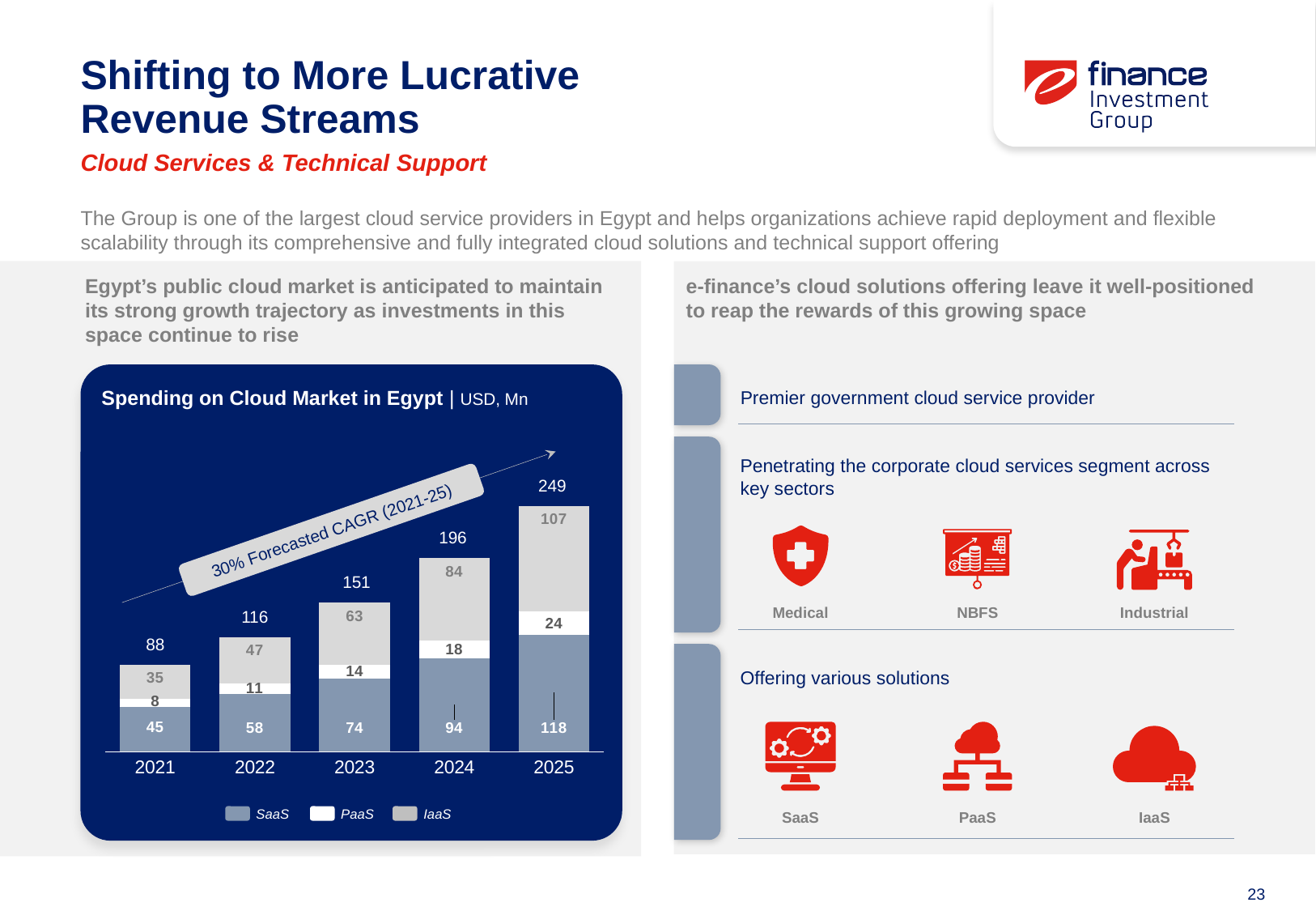
What is the total spending shown for 2024 in the Spending on Cloud Market in Egypt chart? 196 What is the IaaS value for 2025 in the Spending on Cloud Market in Egypt chart? 107 Which year has the lowest total spending in the Spending on Cloud Market in Egypt chart? 2021 What kind of chart is the Spending on Cloud Market in Egypt chart? Stacked bar chart In the Spending on Cloud Market in Egypt chart, which is larger in 2022: the SaaS value or the IaaS value? SaaS Do the total spending values in the Spending on Cloud Market in Egypt chart rise or fall from 2021 to 2025? Rise How many years are shown on the x axis of the Spending on Cloud Market in Egypt chart? 5 What is the SaaS value for 2023 in the Spending on Cloud Market in Egypt chart? 74 Which year has the highest total spending in the Spending on Cloud Market in Egypt chart? 2025 What is the PaaS value for 2021 in the Spending on Cloud Market in Egypt chart? 8 How many series does the legend of the Spending on Cloud Market in Egypt chart list? 3 What is the difference between the total spending in 2025 and 2021 in the Spending on Cloud Market in Egypt chart? 161